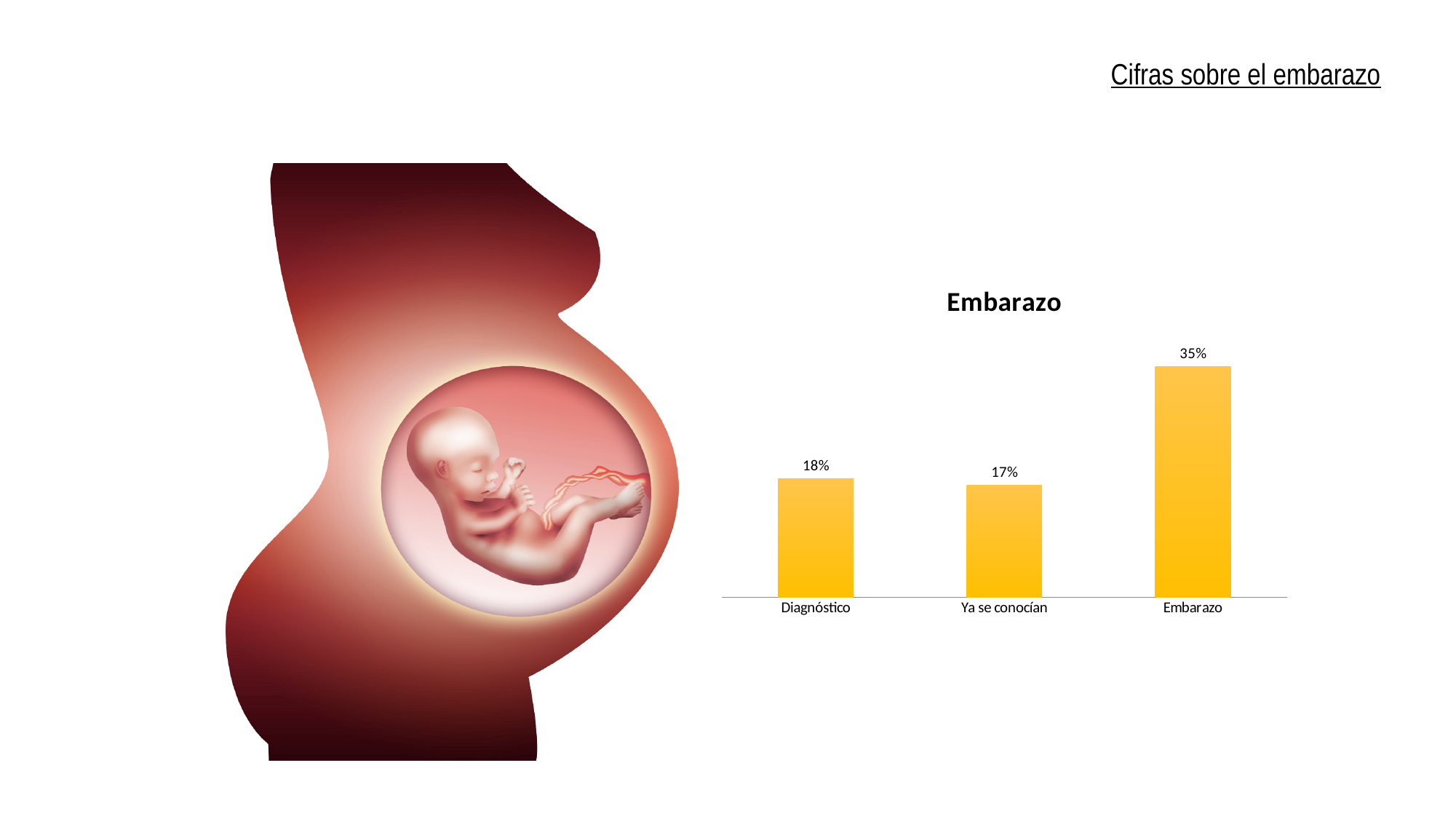
How many categories are shown in the chart? 3 Which is larger, the value for Embarazo or the value for Ya se conocían? Embarazo What is the value for Ya se conocían? 17% What is the title of the chart? Embarazo Which category has the highest value? Embarazo What colour are the bars in the chart? Yellow What kind of chart is shown on the slide? Bar chart What is the difference between the values for Diagnóstico and Ya se conocían? 1% What is the value for Diagnóstico? 18% What is the value for Embarazo? 35% What is the difference between the values for Embarazo and Diagnóstico? 17% Which category has the lowest value? Ya se conocían